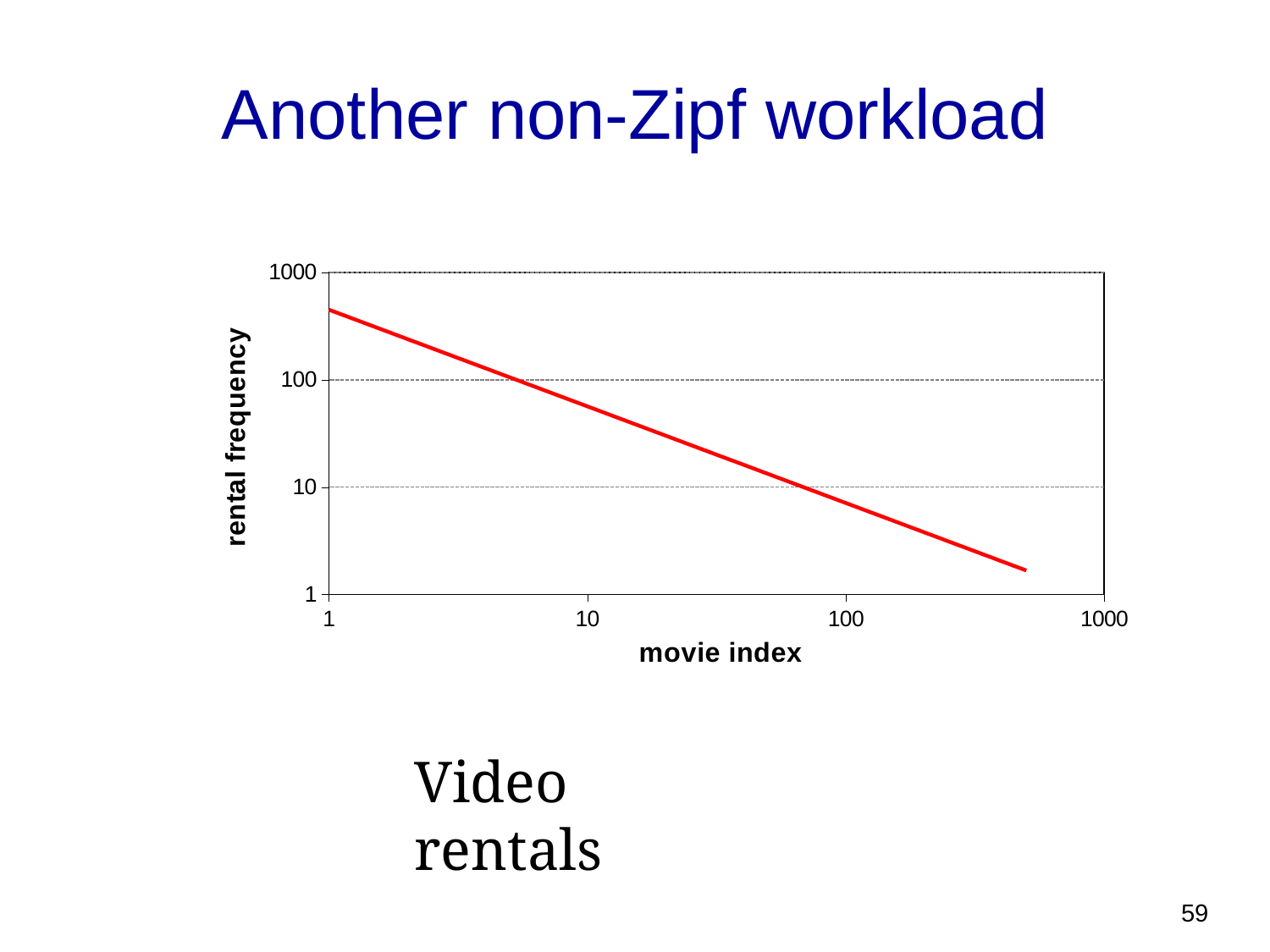
Is the rental frequency at movie index 1 greater or less than 1000? less Is the rental frequency at movie index 1 greater or less than 100? greater Is the rental frequency at movie index 10 greater or less than 100? less What is the label of the x axis of the chart? movie index What kind of chart is shown on the slide? line chart What is the label of the y axis of the chart? rental frequency Which has the higher rental frequency, movie index 1 or movie index 100? movie index 1 Do the values of rental frequency rise or fall as the movie index increases? fall